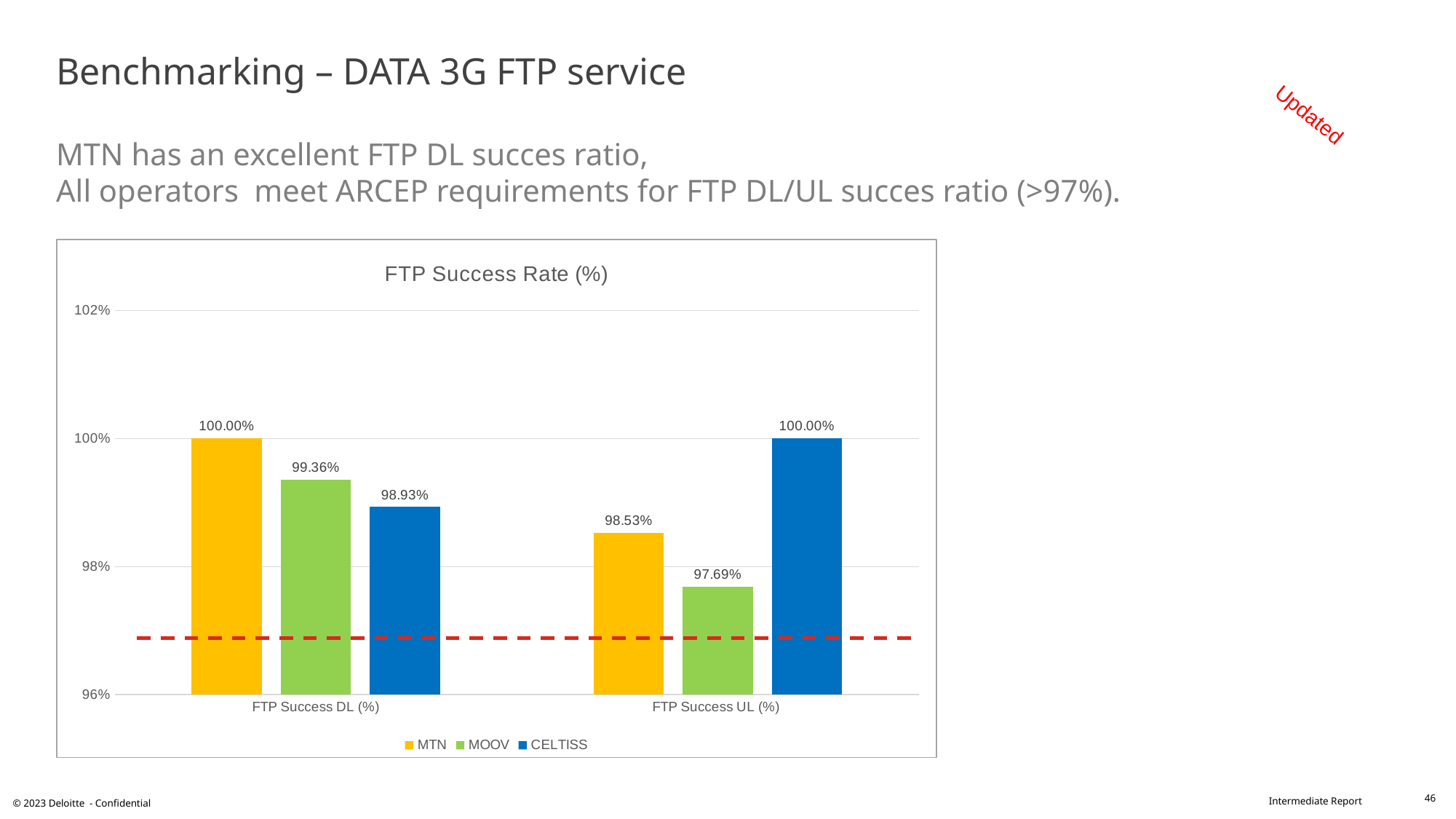
Which operator has the lowest FTP Success DL (%)? CELTISS How many categories are shown on the x axis of the chart? 2 What is the FTP Success DL (%) value for MTN? 100.00% What is the difference between MOOV's FTP Success DL (%) and FTP Success UL (%)? 1.67% What is the FTP Success UL (%) value for MOOV? 97.69% Which is larger: MTN's FTP Success UL (%) or MOOV's FTP Success UL (%)? MTN's FTP Success UL (%) Which operator has the highest FTP Success UL (%)? CELTISS What kind of chart is shown on the slide? Bar chart What is the title of the chart? FTP Success Rate (%) What is the FTP Success DL (%) value for CELTISS? 98.93% Is the FTP Success UL (%) value for MOOV greater or less than 98%? less How many series does the legend list? 3